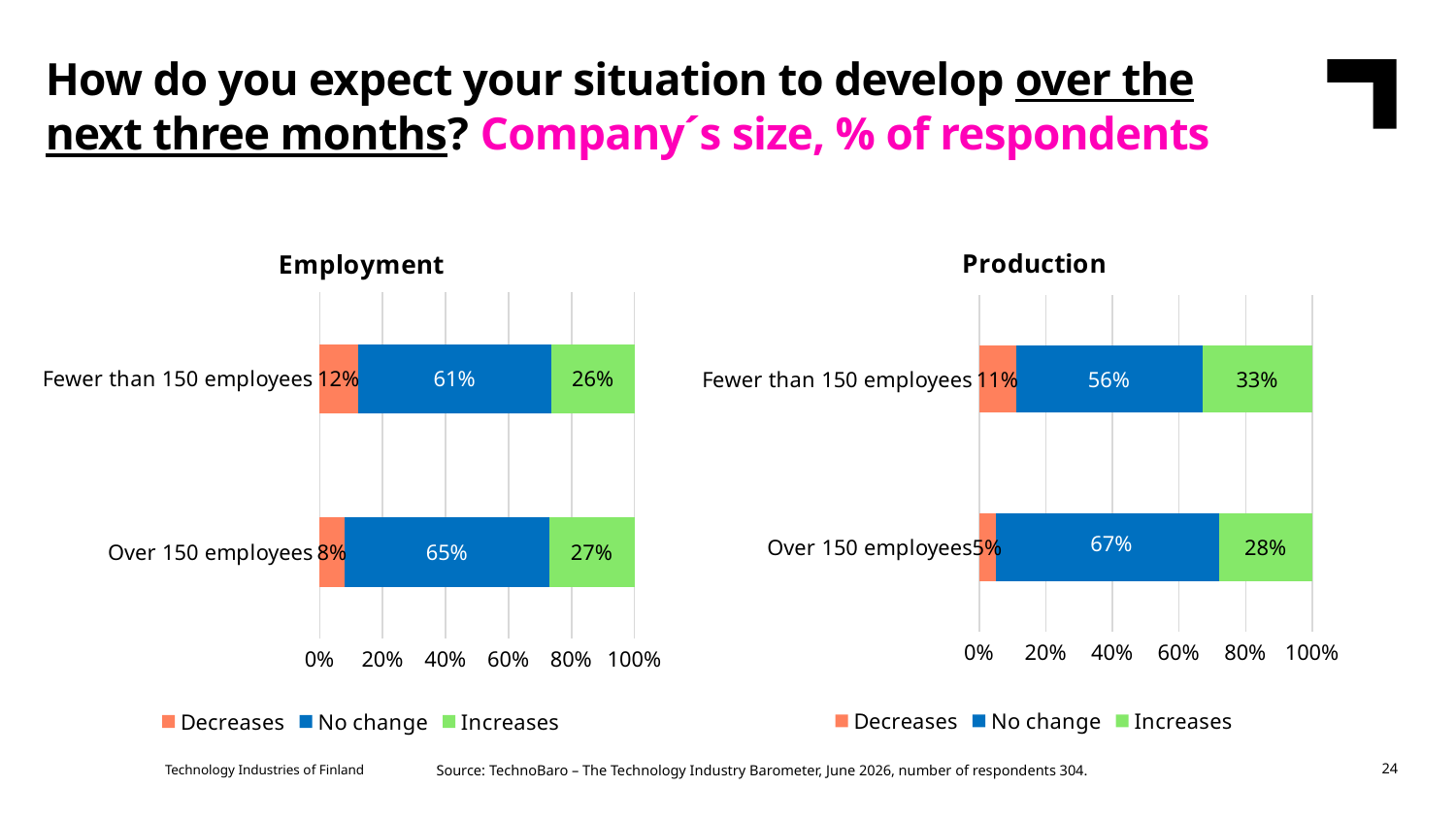
How many series does the legend of the Employment chart list? 3 What kind of chart is the Employment chart? Stacked bar chart In the Employment chart, what percentage of companies with fewer than 150 employees expect no change? 61% In the Production chart, what percentage of companies with fewer than 150 employees expect decreases? 11% In the Production chart, what percentage of companies with over 150 employees expect increases? 28% What colour represents 'Increases' in the charts? Green In the Production chart, which company size has the lowest 'Decreases' share? Over 150 employees How many categories are shown in the Production chart? 2 In the Employment chart, what percentage of companies with over 150 employees expect decreases? 8% In the Production chart, which company size has the higher share expecting no change? Over 150 employees In the Production chart, what is the difference between the 'Increases' shares for fewer than 150 employees and over 150 employees? 5% In the Employment chart, what is the difference between the 'No change' shares for over 150 employees and fewer than 150 employees? 4%